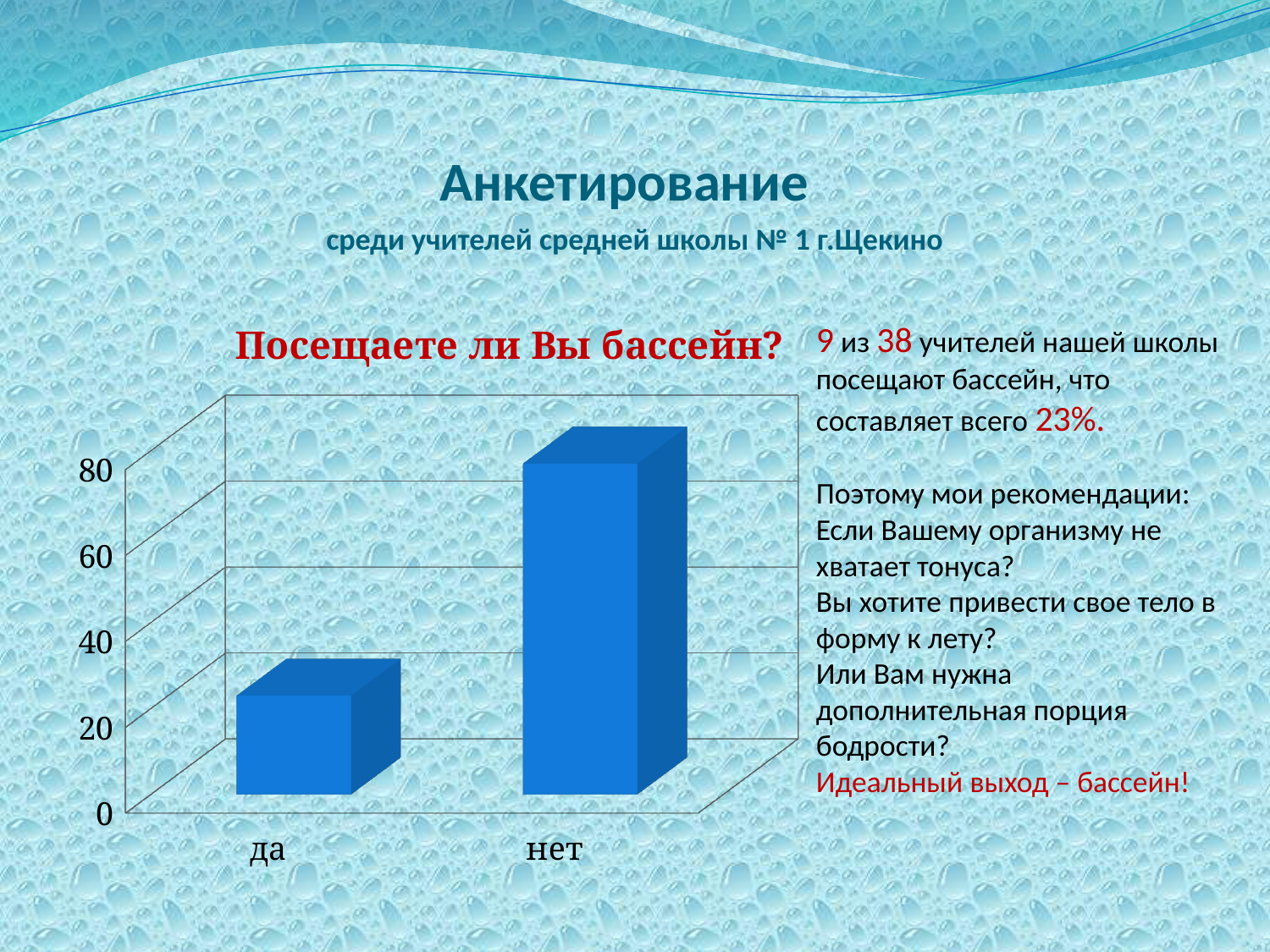
Is the value for "нет" greater or less than 40? greater What are the category labels on the x axis of the chart? да, нет What is the title of the chart? Посещаете ли Вы бассейн? Is the value for "да" greater or less than 60? less Do the bar values rise or fall from "да" to "нет" along the x axis? rise Which category has the lowest bar in the chart? да Is the value for "нет" greater or less than 60? greater How many categories are shown on the x axis of the chart? 2 Which category has the highest bar in the chart? нет Which bar is taller, "да" or "нет"? нет What kind of chart is shown on the slide? bar chart